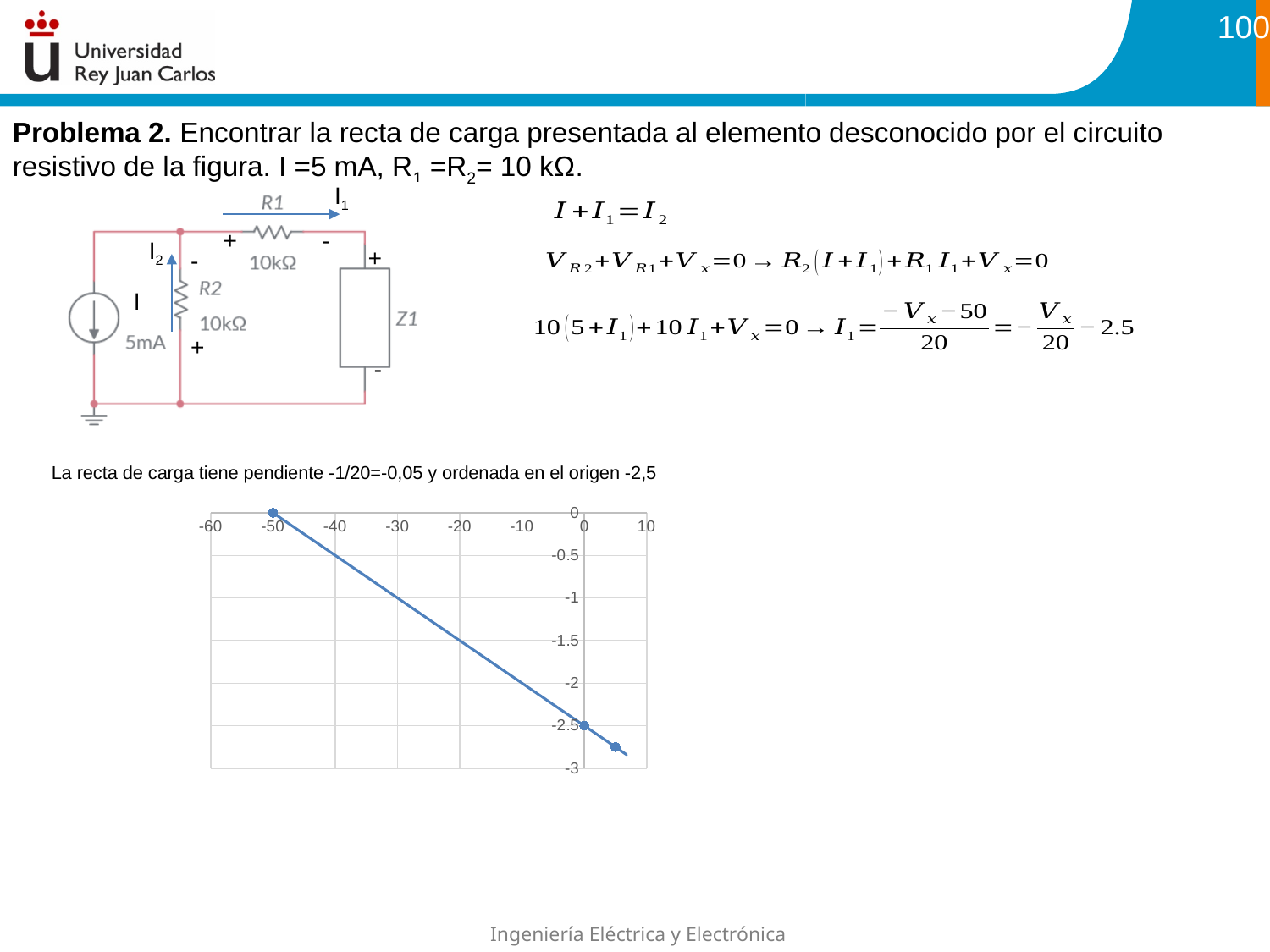
Is the y value of the line at x = -40 greater or less than -1? greater What kind of chart is shown on the slide? line chart Do the plotted values rise or fall as the x value increases? fall Is the y value of the rightmost data point greater or less than -2.5? less What is the y value of the data point at x = 0? -2.5 How many data points are marked on the line? 3 What is the lowest value shown on the y axis? -3 Which data point has the larger y value, the one at x = -50 or the one at x = 0? the one at x = -50 At which x value does the line reach its highest y value? -50 What is the y value of the data point at x = -50? 0 What is the leftmost value shown on the x axis? -60